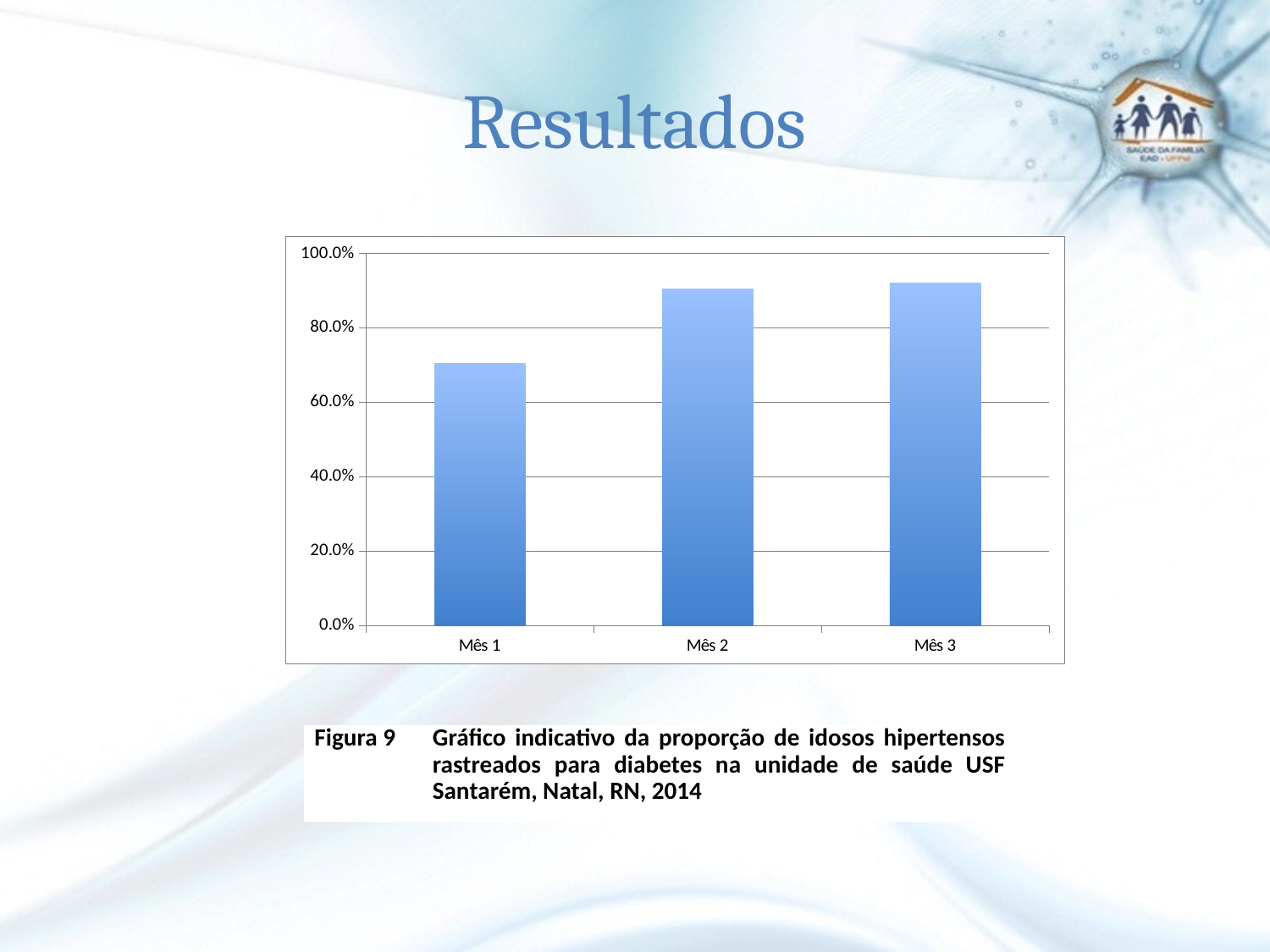
Which month has the lowest value in the chart? Mês 1 Is the value for Mês 3 greater or less than 80%? greater What is the figure number given in the caption below the chart? Figura 9 Is the value for Mês 1 greater or less than 80%? less How many categories (months) are shown on the x axis of the chart? 3 Which is larger, the value for Mês 1 or the value for Mês 2? Mês 2 What is the highest value shown on the y axis of the chart? 100.0% Is the value for Mês 3 greater or less than 100%? less What kind of chart is shown on the slide? bar chart Do the values rise or fall from Mês 1 to Mês 3? rise